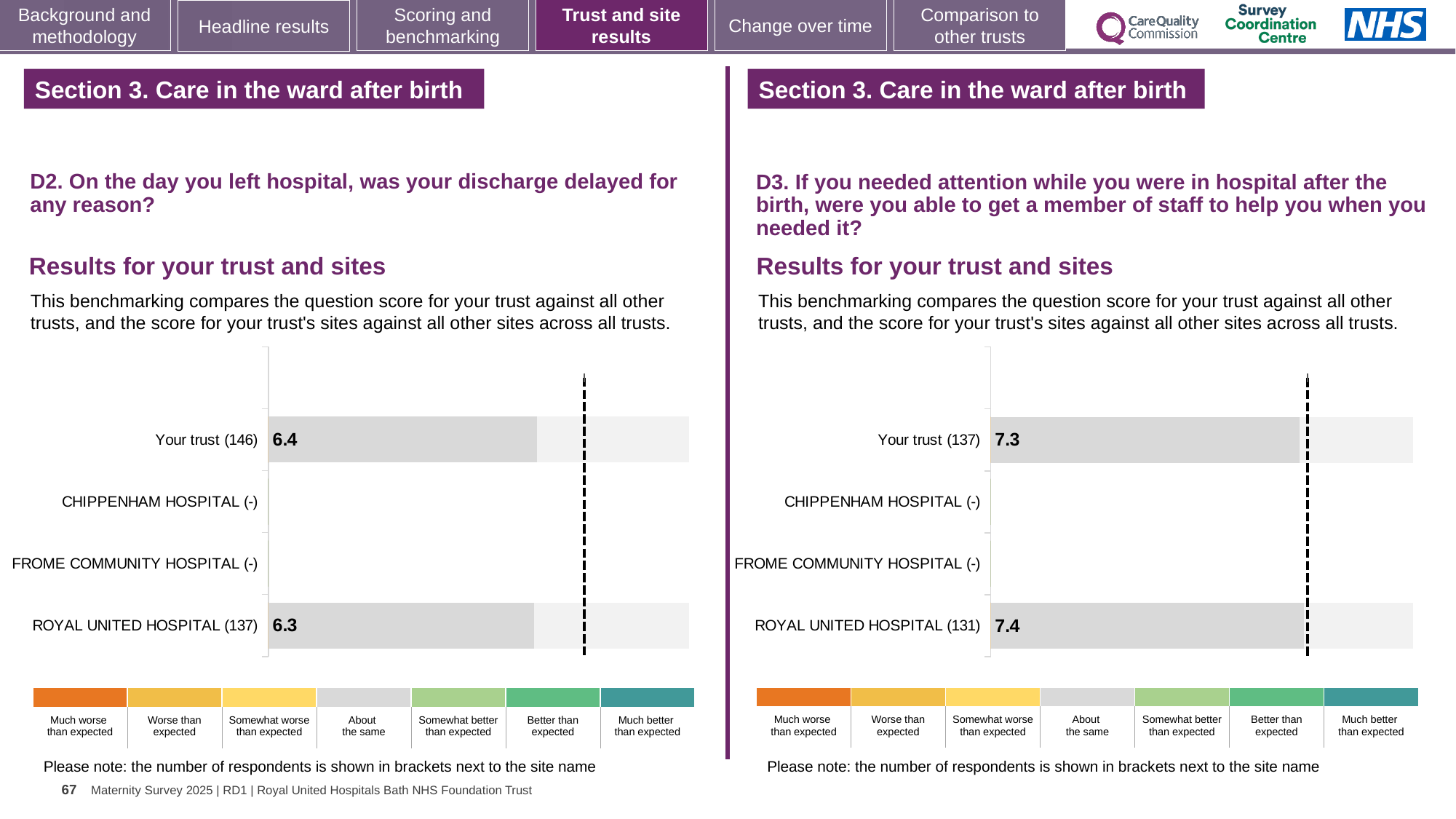
In the right chart (D3, able to get a member of staff to help), what is the score for Your trust? 7.3 In the right chart (D3), what is the difference between the score for Royal United Hospital and the score for Your trust? 0.1 In the left chart (D2), how many respondents are shown in brackets for Your trust? 146 In the left chart (D2), which has the higher score: Your trust or Royal United Hospital? Your trust In the right chart (D3), how many respondents are shown in brackets for Royal United Hospital? 131 In the left chart (D2), what is the difference between the score for Your trust and the score for Royal United Hospital? 0.1 In the right chart (D3), which has the higher score: Your trust or Royal United Hospital? Royal United Hospital How many categories (rows) are listed on the left chart (D2)? 4 In the right chart (D3, able to get a member of staff to help), what is the score for Royal United Hospital? 7.4 In the left chart (D2, discharge delayed), what is the score for Your trust? 6.4 In the left chart (D2, discharge delayed), what is the score for Royal United Hospital? 6.3 What kind of chart is used on the right side of the slide (D3)? Bar chart